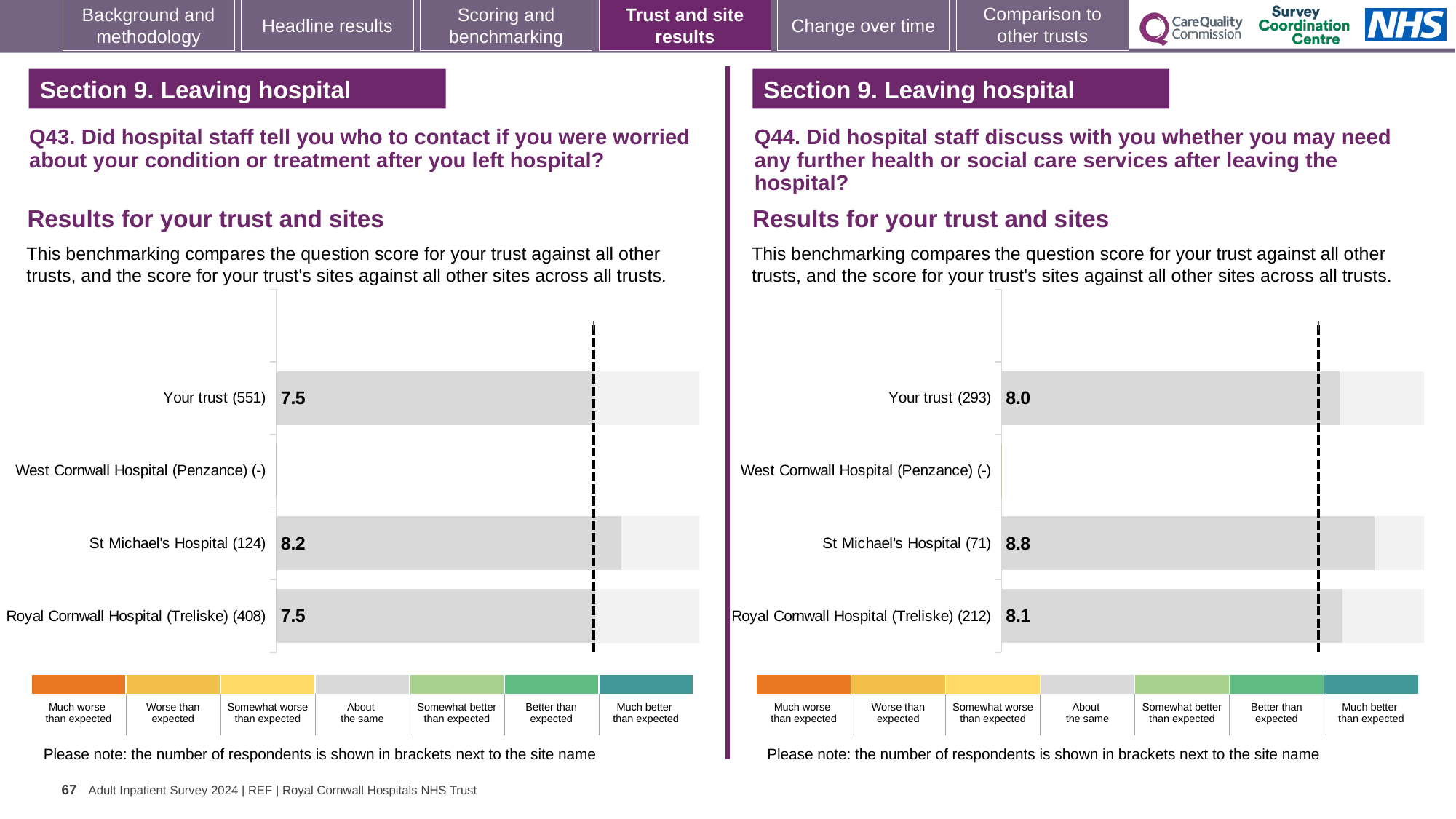
In the Q43 chart on the left, what is the score for St Michael's Hospital? 8.2 In the Q44 chart on the right, what is the score for Your trust? 8.0 In the Q44 chart on the right, what is the score for Royal Cornwall Hospital (Treliske)? 8.1 In the Q43 chart on the left, which site has the highest score? St Michael's Hospital In the Q43 chart on the left, what is the score for Royal Cornwall Hospital (Treliske)? 7.5 In the Q44 chart on the right, which is larger: the score for St Michael's Hospital or the score for Royal Cornwall Hospital (Treliske)? St Michael's Hospital In the Q43 chart on the left, what is the score for Your trust? 7.5 In the Q44 chart on the right, which site has the highest score? St Michael's Hospital In the Q43 chart on the left, what is the difference between the scores for St Michael's Hospital and Royal Cornwall Hospital (Treliske)? 0.7 In the Q44 chart on the right, what is the difference between the scores for St Michael's Hospital and Your trust? 0.8 What kind of chart is used in the Q43 chart on the left? Bar chart In the Q44 chart on the right, what is the score for St Michael's Hospital? 8.8